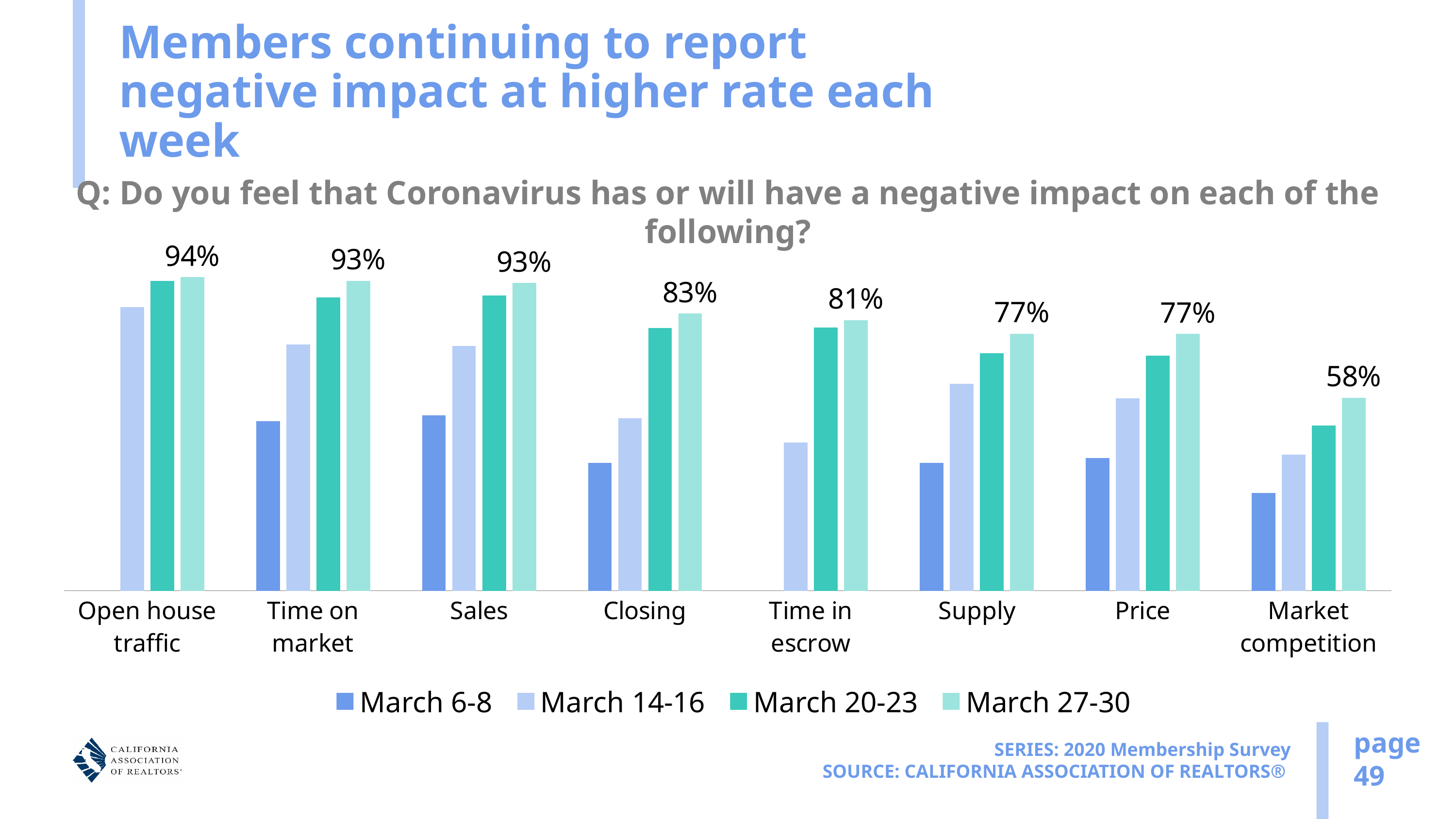
What is the value for Time in escrow in the March 27-30 series? 81% How many categories are shown on the x axis? 8 Which category has the highest value in the March 27-30 series? Open house traffic What is the difference between the March 27-30 values for Open house traffic and Market competition? 36 percentage points Do the March 27-30 values rise or fall from left to right across the categories? Fall What is the value for Closing in the March 27-30 series? 83% Which category has the lowest value in the March 27-30 series? Market competition How many series does the legend list? 4 What is the value for Market competition in the March 27-30 series? 58% What kind of chart is shown on the slide? Bar chart What is the value for Open house traffic in the March 27-30 series? 94% In the March 27-30 series, which is larger: Closing or Time in escrow? Closing